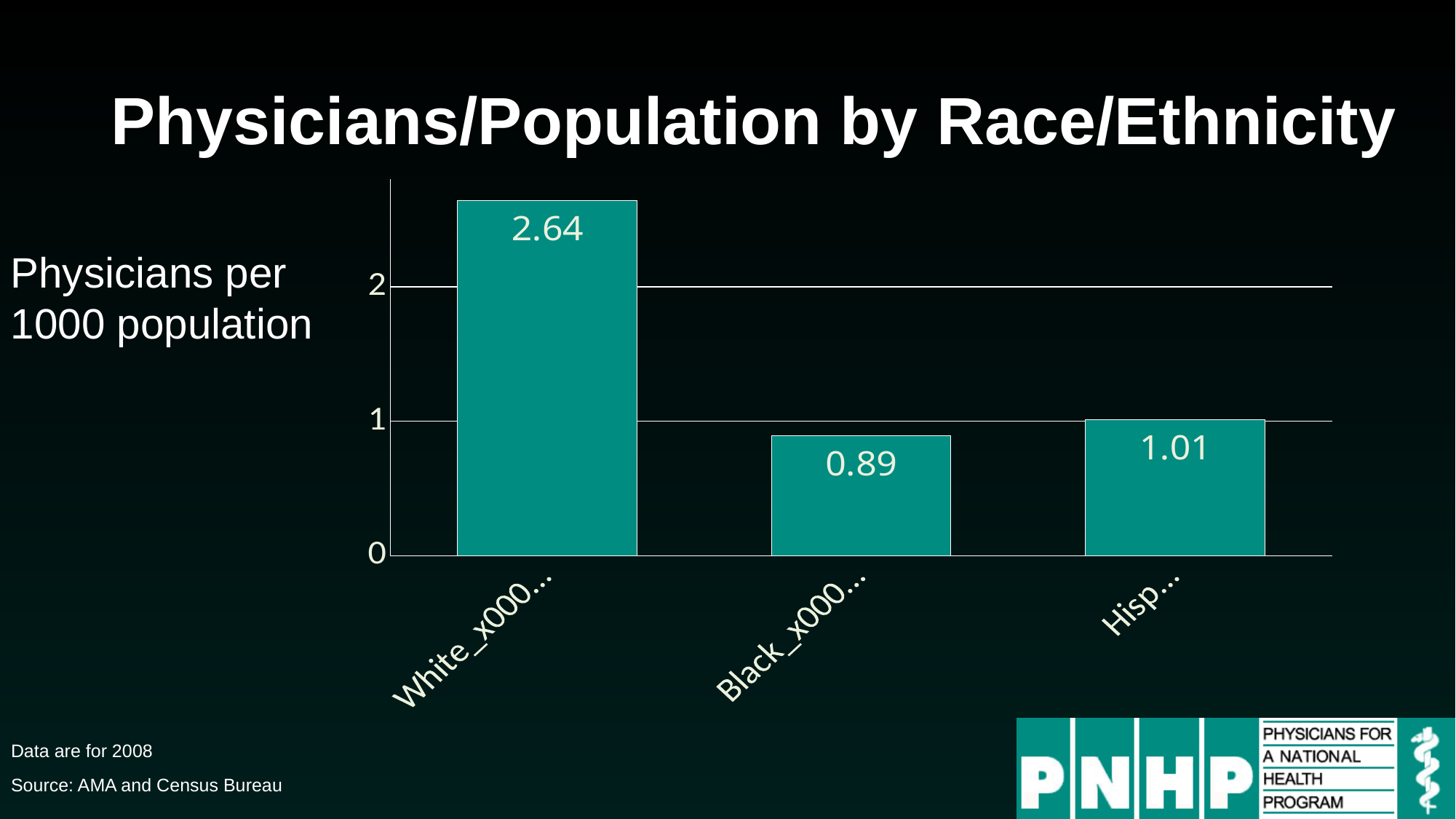
Which category has the highest physicians per 1000 population? White What is the difference between the rightmost bar (Hisp…) and the Black bar? 0.12 Is the value for White greater or less than 2? greater What is the value for Black in the chart? 0.89 How many bars are shown in the chart? 3 Which is larger, the value for White or the value for Black? White What is the value for White in the Physicians/Population by Race/Ethnicity chart? 2.64 What kind of chart is shown on the slide? Bar chart Which category has the lowest physicians per 1000 population? Black What is the value shown on the rightmost bar (labelled 'Hisp…')? 1.01 What unit does the text to the left of the chart say the values are measured in? Physicians per 1000 population What is the difference between the values for White and Black? 1.75